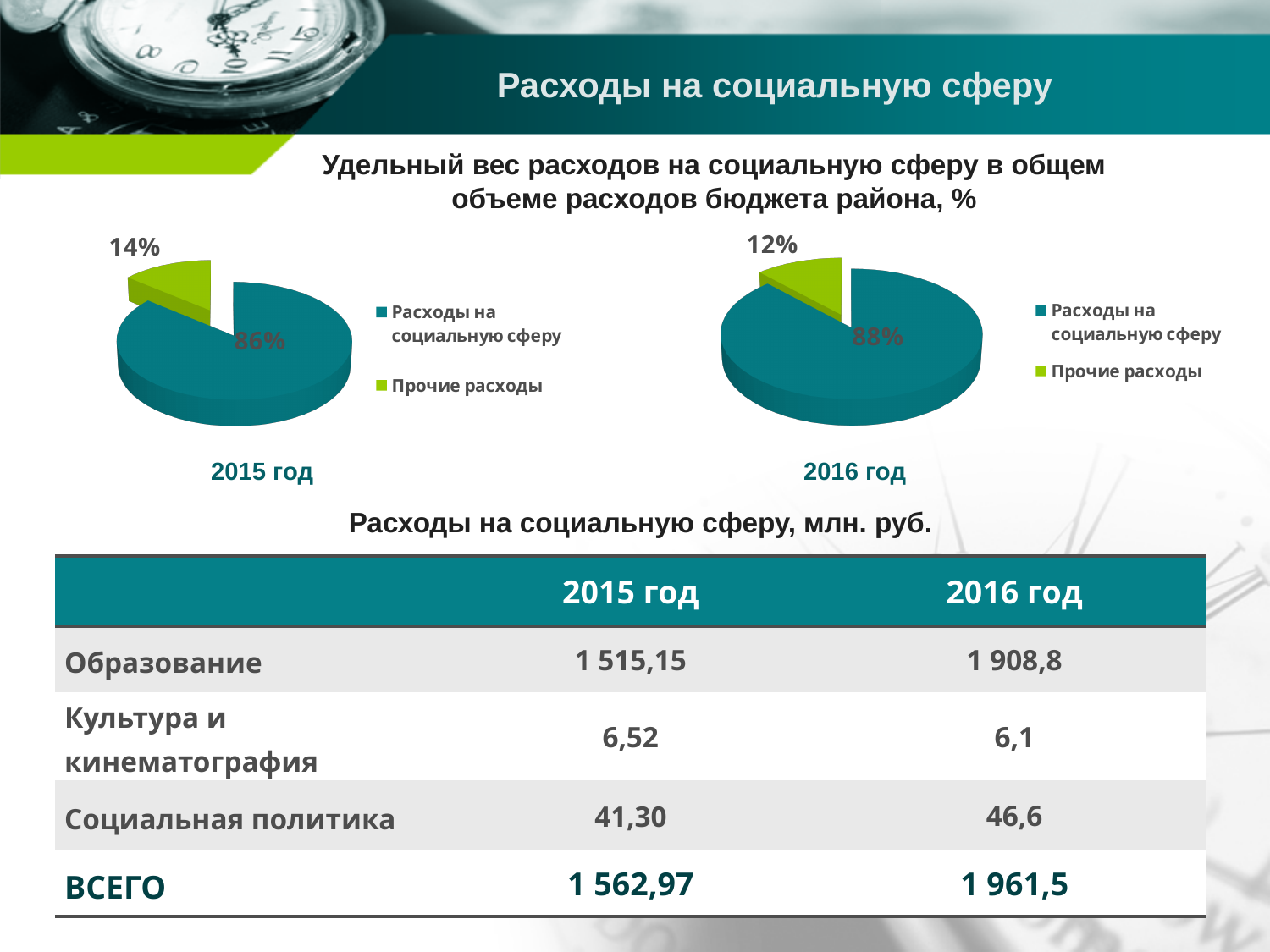
How many slices does the 2015 год pie chart have? 2 What is the difference between the share of Расходы на социальную сферу in the 2016 год pie chart and in the 2015 год pie chart? 2% In the 2016 год pie chart, which slice is the smallest? Прочие расходы In the 2015 год pie chart, what share is labelled for Расходы на социальную сферу? 86% In the 2015 год pie chart, which slice is the largest? Расходы на социальную сферу Which is larger: the share of Прочие расходы in the 2015 год pie chart or in the 2016 год pie chart? 2015 год What type of chart is used to show the 2015 год data? Pie chart How many entries does the legend of the 2016 год pie chart list? 2 In the 2015 год pie chart, what share is labelled for Прочие расходы? 14% In the 2016 год pie chart, what share is labelled for Прочие расходы? 12% In the 2016 год pie chart, what colour is the Прочие расходы slice? Green